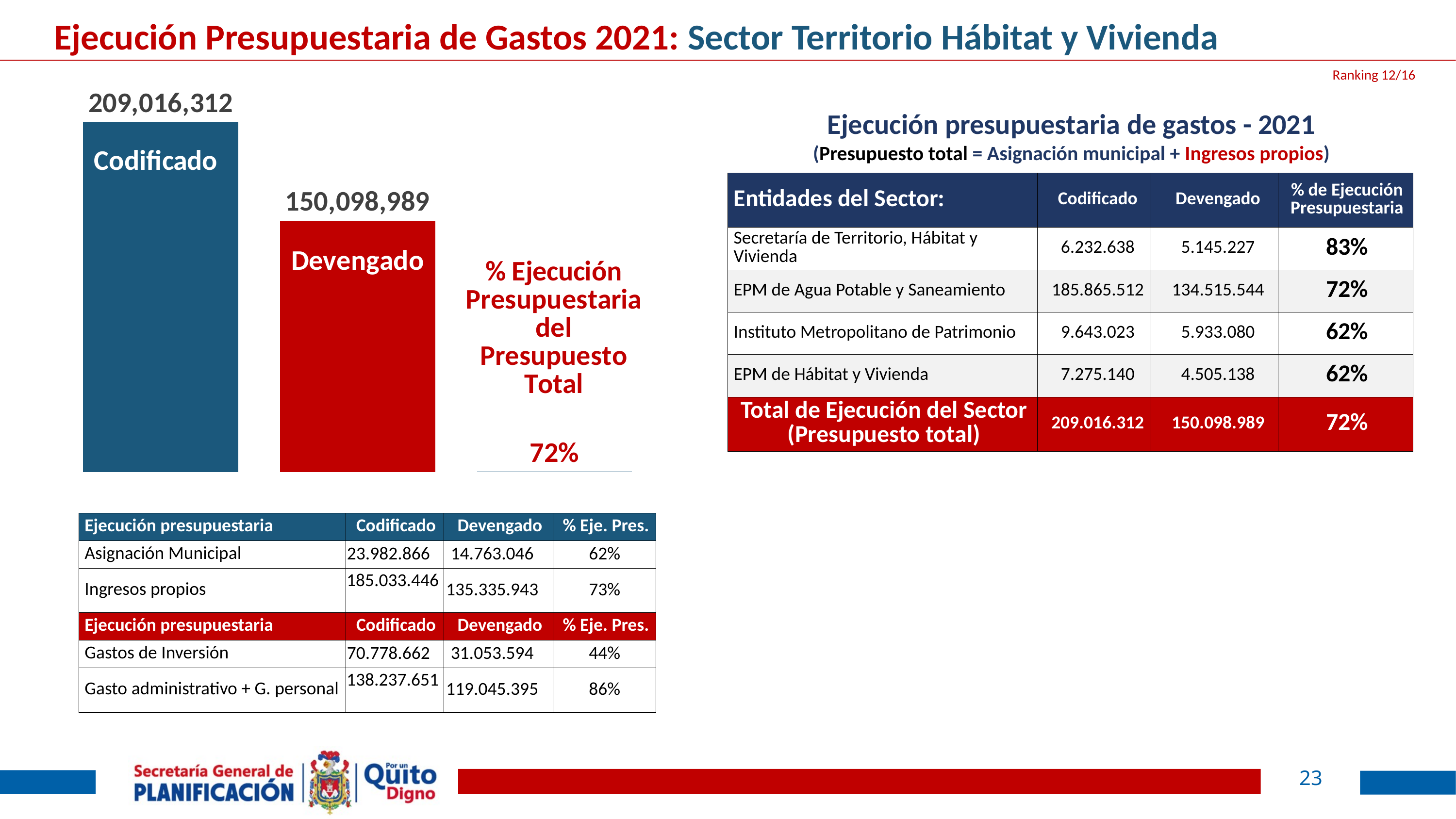
Which bar in the chart is the lowest? Devengado What is the value of the Devengado bar in the bar chart? 150,098,989 Which is larger in the bar chart, Codificado or Devengado? Codificado What is the value of the Codificado bar in the bar chart? 209,016,312 What percentage is shown next to the bar chart as the % Ejecución Presupuestaria del Presupuesto Total? 72% What colour is the Devengado bar in the chart? Red How many bars are shown in the bar chart? 2 What type of chart is shown on the left of the slide? Bar chart Which bar in the chart is the highest? Codificado What is the difference between the Codificado and Devengado bars in the chart? 58,917,323